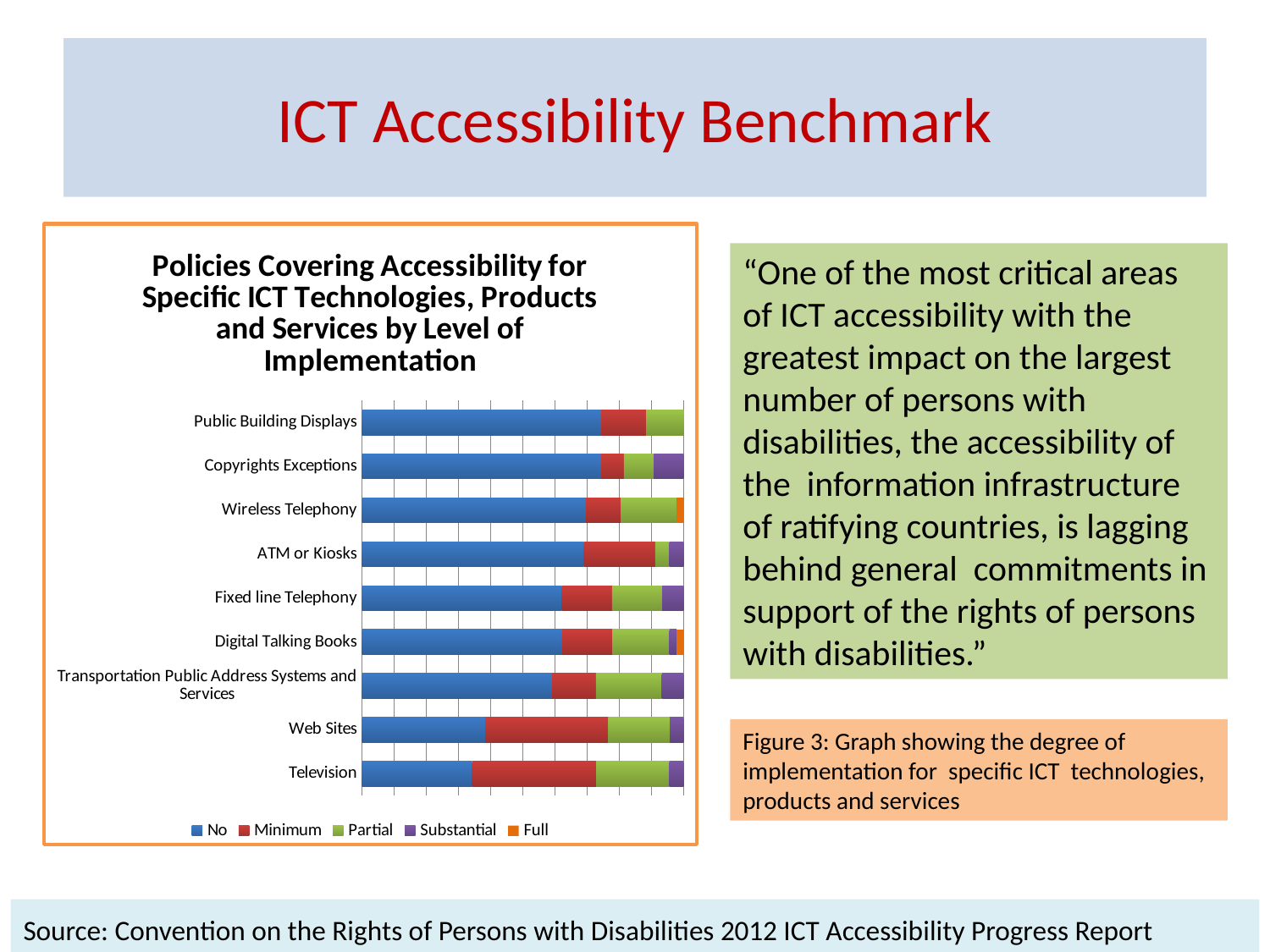
Which has a longer 'Minimum' segment, Television or Public Building Displays? Television Which has a longer 'No' segment, Television or Public Building Displays? Public Building Displays What is the title of the chart? Policies Covering Accessibility for Specific ICT Technologies, Products and Services by Level of Implementation Which category is listed at the top of the chart? Public Building Displays How many ICT technology/product/service categories are plotted in the chart? 9 Which has a longer 'No' segment, Web Sites or Wireless Telephony? Wireless Telephony What are the five levels of implementation listed in the chart legend? No, Minimum, Partial, Substantial, Full What kind of chart is shown on the slide? Stacked bar chart Which category has the shortest 'No' segment? Television How many series does the chart legend list? 5